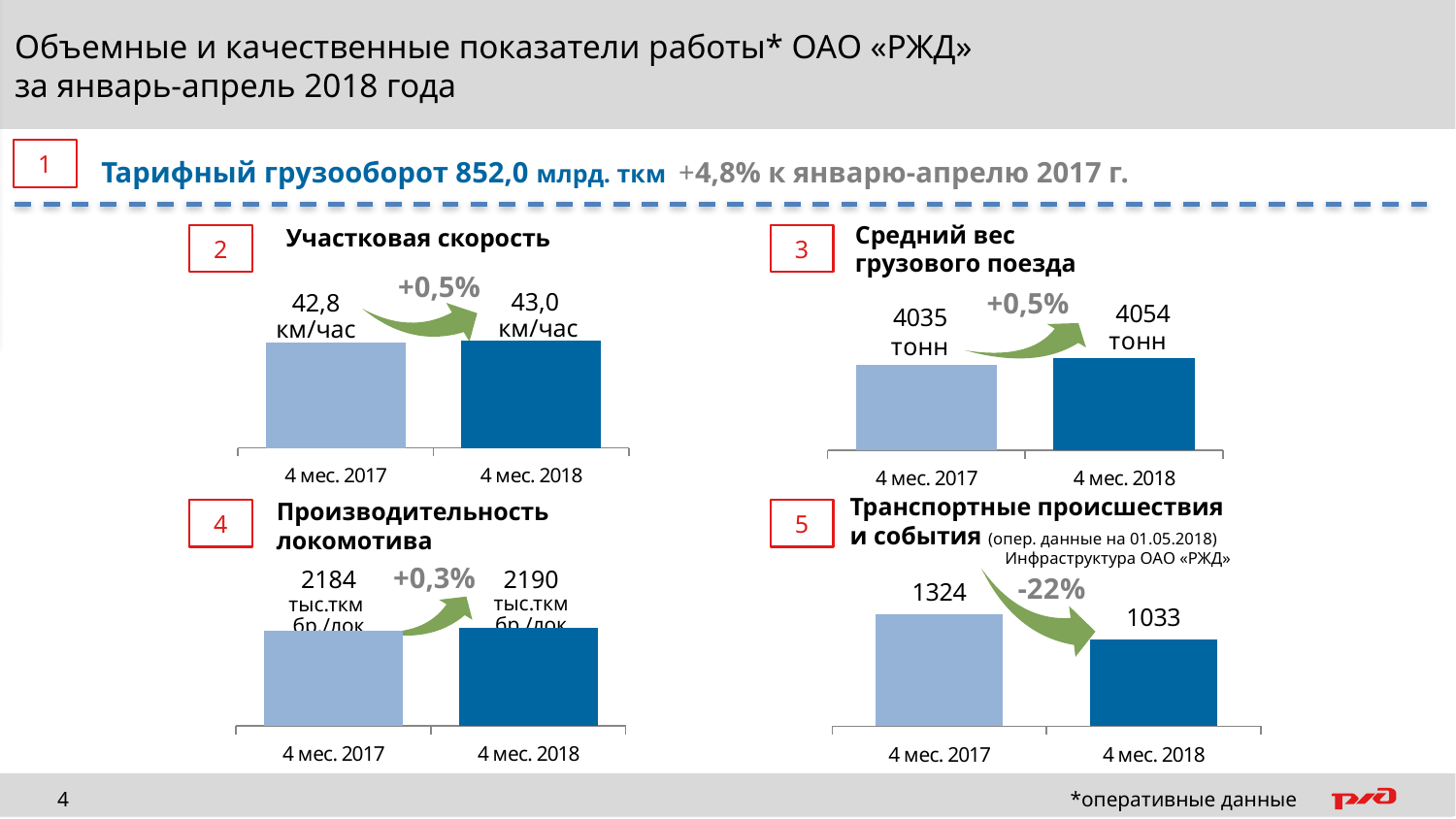
In the 'Транспортные происшествия и события' chart, what is the difference between 4 мес. 2017 and 4 мес. 2018? 291 In the 'Средний вес грузового поезда' chart, what is the difference between 4 мес. 2018 and 4 мес. 2017? 19 тонн In the 'Транспортные происшествия и события' chart, which category has the higher value, 4 мес. 2017 or 4 мес. 2018? 4 мес. 2017 In the 'Участковая скорость' chart, what is the value for 4 мес. 2017? 42,8 км/час In the 'Транспортные происшествия и события' chart, do the values rise or fall from 4 мес. 2017 to 4 мес. 2018? fall What kind of chart is the 'Средний вес грузового поезда' chart? bar chart In the 'Средний вес грузового поезда' chart, what is the value for 4 мес. 2018? 4054 тонн How many categories are shown in the 'Участковая скорость' chart? 2 In the 'Производительность локомотива' chart, what is the value for 4 мес. 2017? 2184 тыс.ткм бр./лок In the 'Участковая скорость' chart, what is the value for 4 мес. 2018? 43,0 км/час In the 'Производительность локомотива' chart, what percentage change is shown between the two bars? +0,3% In the 'Транспортные происшествия и события' chart, what is the value for 4 мес. 2018? 1033